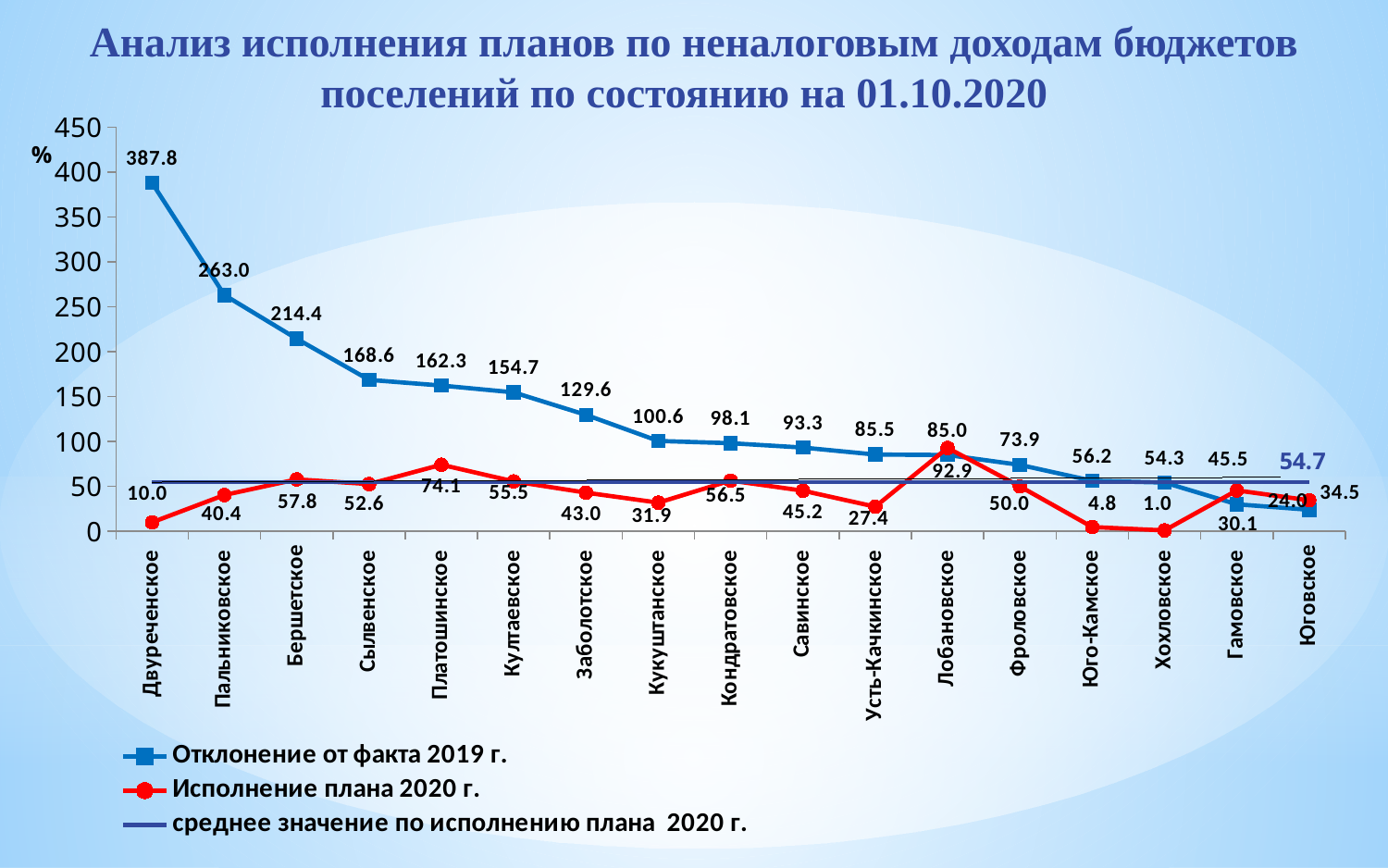
What is the value of the 'Исполнение плана 2020 г.' series for Усть-Качкинское? 27.4 What is the value of the 'Исполнение плана 2020 г.' series for Платошинское? 74.1 How many series does the legend list? 3 What is the value of the average line 'среднее значение по исполнению плана 2020 г.'? 54.7 In the 'Исполнение плана 2020 г.' series, which is larger: Лобановское or Фроловское? Лобановское Which settlement has the lowest value in the 'Исполнение плана 2020 г.' series? Хохловское What is the value of the 'Отклонение от факта 2019 г.' series for Двуреченское? 387.8 What is the value of the 'Отклонение от факта 2019 г.' series for Сылвенское? 168.6 How many settlements are shown on the x axis? 17 What is the difference between the 'Отклонение от факта 2019 г.' values for Двуреченское and Пальниковское? 124.8 Which settlement has the highest value in the 'Исполнение плана 2020 г.' series? Лобановское What kind of chart is shown on the slide? Line chart